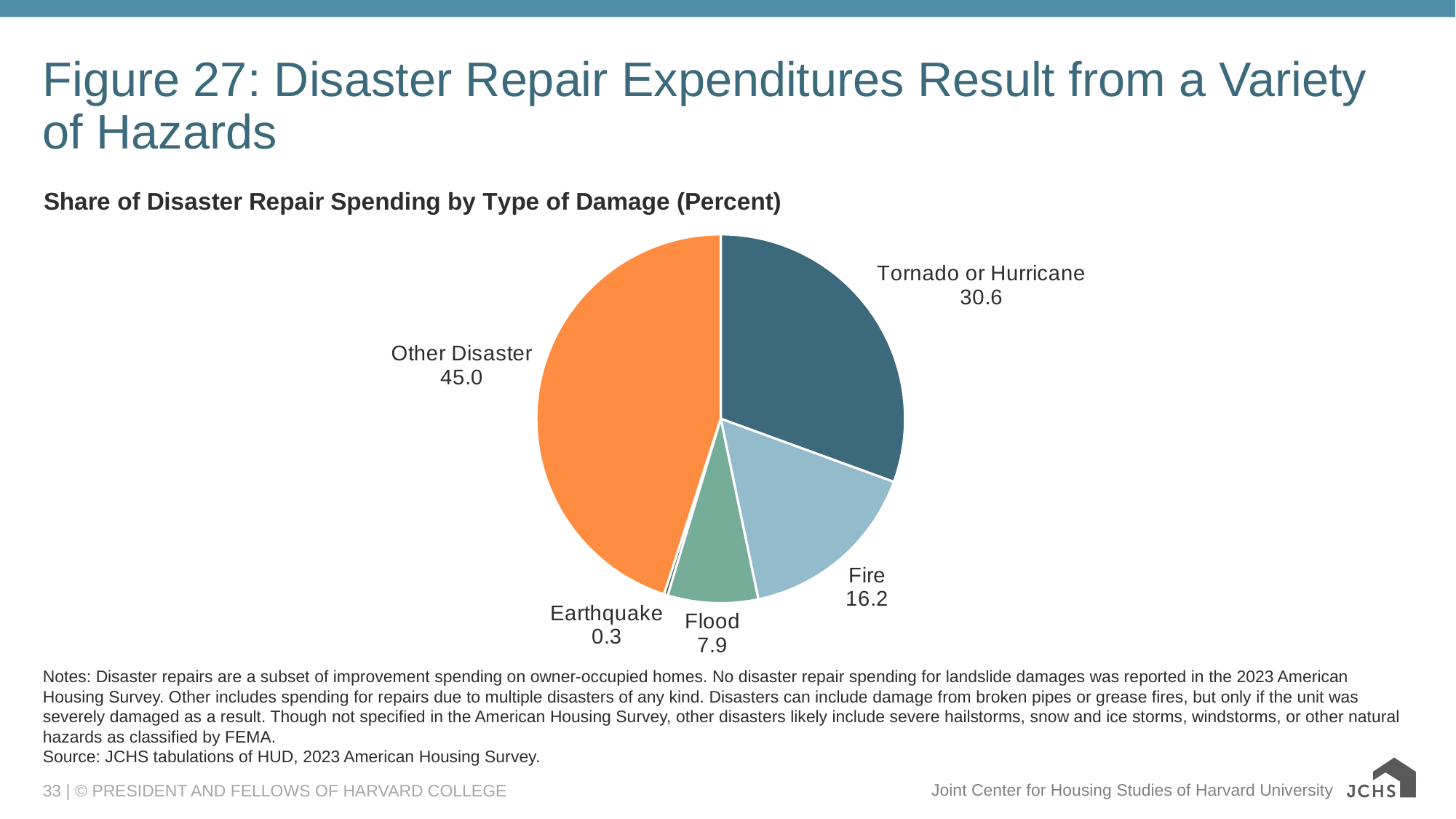
What kind of chart is shown on the slide? Pie chart How many types of damage are shown in the pie chart? 5 What share of disaster repair spending is attributed to Flood? 7.9 Which type of damage has the smallest share of disaster repair spending? Earthquake Which type of damage has the largest share of disaster repair spending? Other Disaster What share of disaster repair spending is attributed to Fire? 16.2 What share of disaster repair spending is attributed to Earthquake? 0.3 What is the difference between the shares for Other Disaster and Tornado or Hurricane? 14.4 What share of disaster repair spending is attributed to Tornado or Hurricane? 30.6 Which has a larger share of disaster repair spending, Fire or Flood? Fire What is the title of the chart? Share of Disaster Repair Spending by Type of Damage (Percent) What is the difference between the shares for Fire and Flood? 8.3